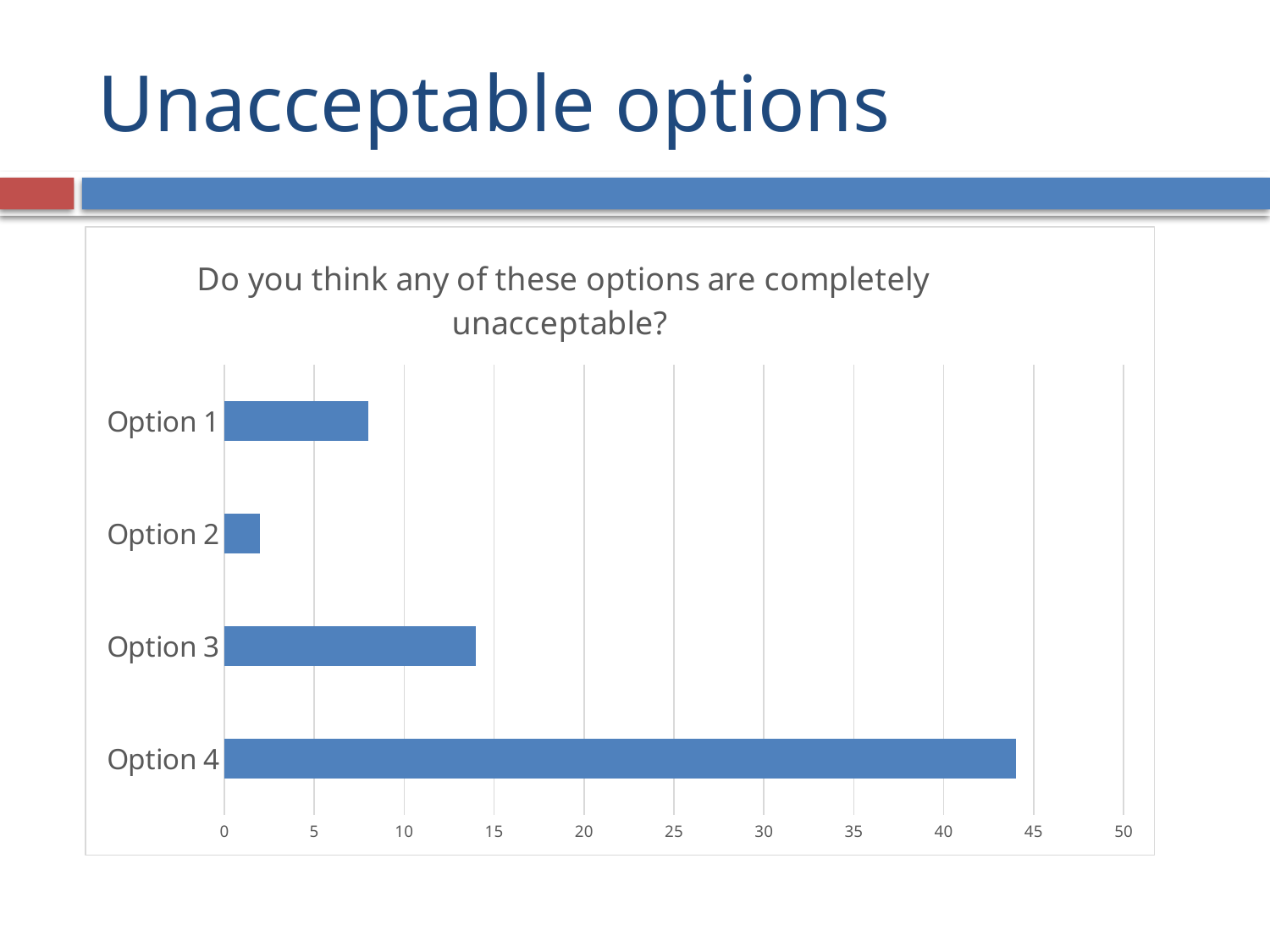
Is the value for Option 2 greater or less than 5? less Which is larger, the value for Option 1 or the value for Option 3? Option 3 Which option has the highest value? Option 4 Is the value for Option 1 greater or less than 5? greater What is the title of the chart? Do you think any of these options are completely unacceptable? What kind of chart is shown on the slide? bar chart How many options (categories) are plotted in the chart? 4 What is the maximum value shown on the horizontal axis? 50 Is the value for Option 3 greater or less than 10? greater Which option has the lowest value? Option 2